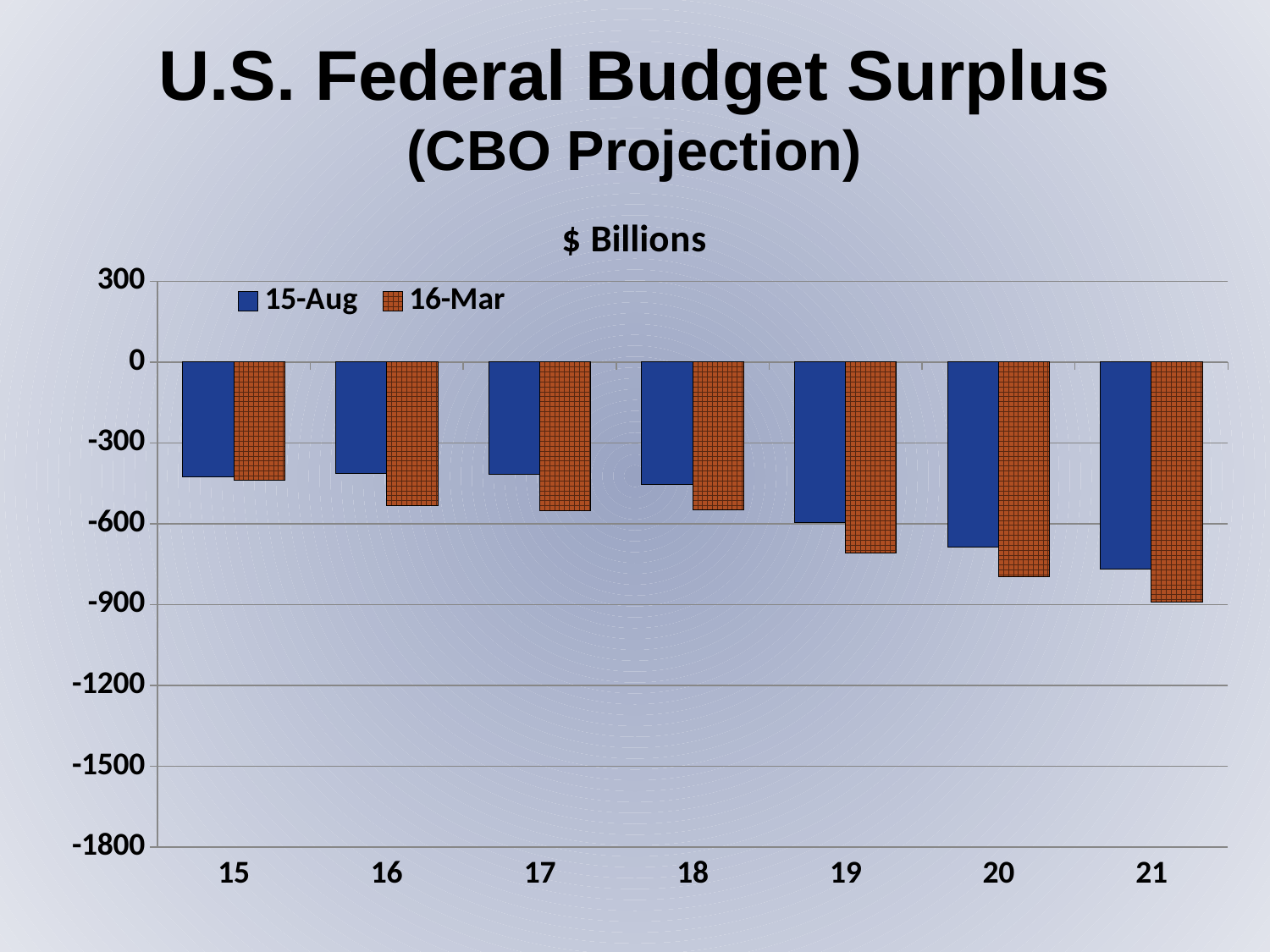
Which year has the lowest (most negative) value for the 16-Mar series? 21 How many years are shown along the x axis? 7 Is the 16-Mar value for year 21 greater or less than -600? less What kind of chart is shown on the slide? bar chart Do the 16-Mar values rise or fall from year 15 to year 21? fall Which year has the lowest (most negative) value for the 15-Aug series? 21 For year 20, which series has the larger (less negative) value, 15-Aug or 16-Mar? 15-Aug Is the 15-Aug value for year 15 greater or less than -600? greater Which year has the highest (least negative) value for the 16-Mar series? 15 What unit is shown above the chart? $ Billions How many series does the legend list? 2 For year 16, which series has the larger (less negative) value, 15-Aug or 16-Mar? 15-Aug